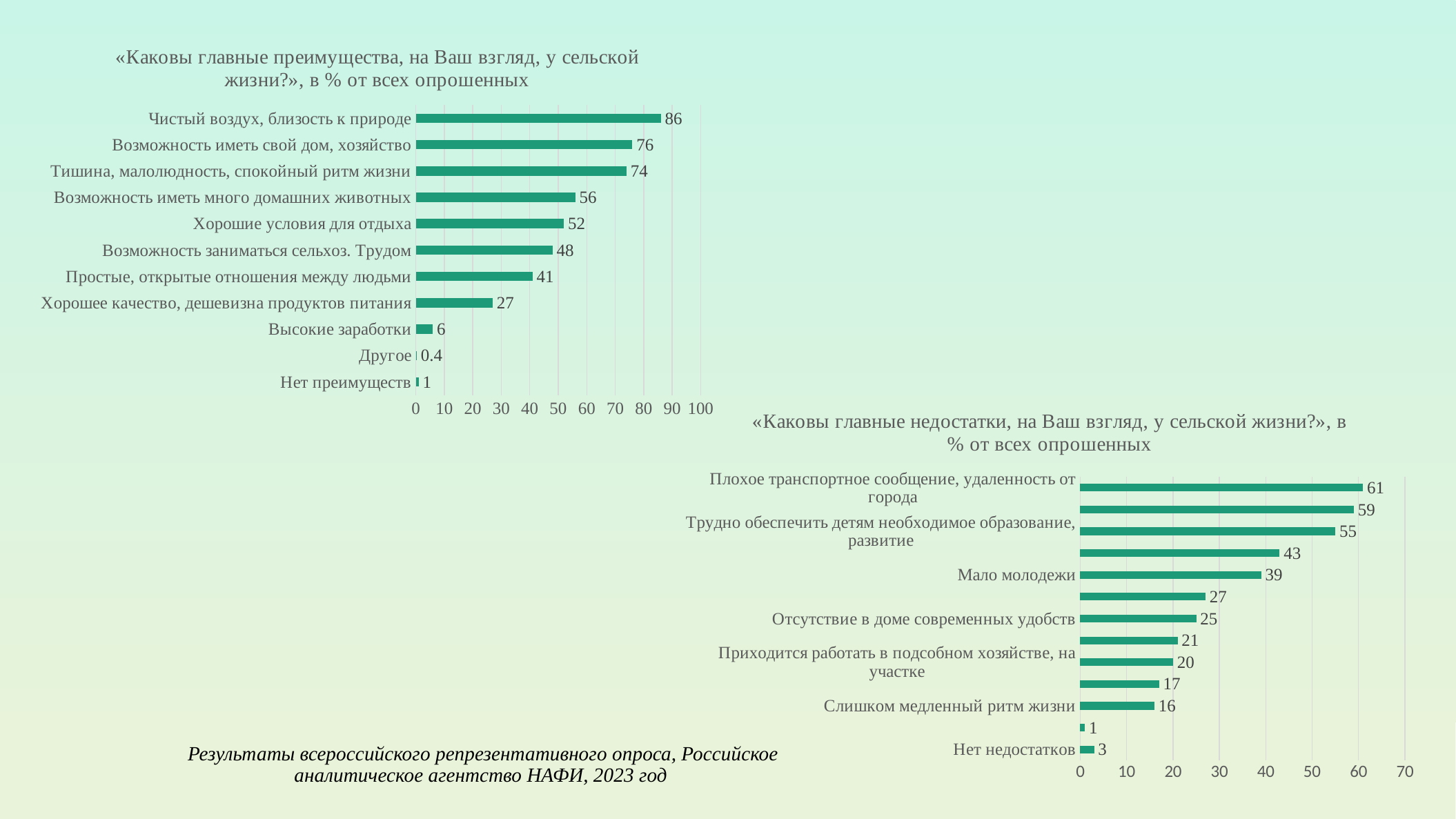
In the chart on the left about the advantages of rural life, what is the difference between «Возможность иметь свой дом, хозяйство» and «Тишина, малолюдность, спокойный ритм жизни»? 2 In the chart on the left about the advantages of rural life, which category has the lowest value? Другое In the chart on the right about the disadvantages of rural life, which is larger: «Отсутствие в доме современных удобств» or «Слишком медленный ритм жизни»? Отсутствие в доме современных удобств In the chart on the right about the disadvantages of rural life, what is the difference between «Плохое транспортное сообщение, удаленность от города» and «Трудно обеспечить детям необходимое образование, развитие»? 6 In the chart on the left about the advantages of rural life, what is the value for «Высокие заработки»? 6 In the chart on the left about the advantages of rural life, what is the value for «Чистый воздух, близость к природе»? 86 In the chart on the left about the advantages of rural life, how many categories are shown? 11 In the chart on the right about the disadvantages of rural life, what is the value for «Мало молодежи»? 39 What type of chart is used on the left to show the advantages of rural life? Bar chart In the chart on the left about the advantages of rural life, which category has the highest value? Чистый воздух, близость к природе In the chart on the right about the disadvantages of rural life, what is the value for «Плохое транспортное сообщение, удаленность от города»? 61 In the chart on the right about the disadvantages of rural life, what is the value for «Нет недостатков»? 3